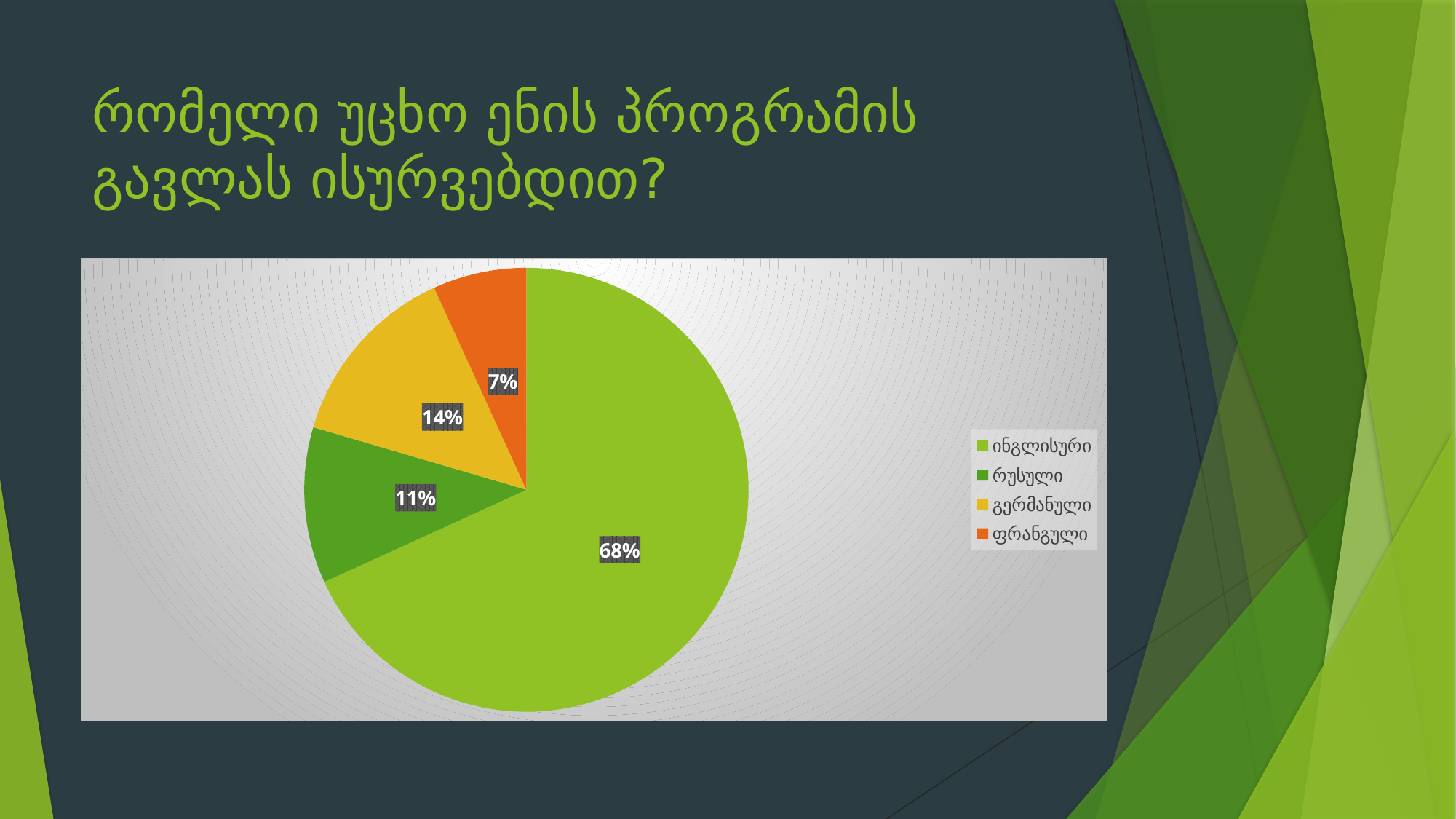
What percentage of the pie is the გერმანული slice? 14% What is the difference in percentage points between the ინგლისური and გერმანული slices? 54 Which slice is larger, გერმანული or რუსული? გერმანული What percentage of the pie is the ფრანგული slice? 7% Which category has the smallest share of the pie? ფრანგული Which category has the largest share of the pie? ინგლისური How many slices does the pie chart have? 4 What kind of chart is shown on the slide? pie chart What percentage of the pie is the ინგლისური slice? 68% What colour is the ფრანგული slice in the pie chart? orange What percentage of the pie is the რუსული slice? 11% What is the combined share of the რუსული and ფრანგული slices? 18%